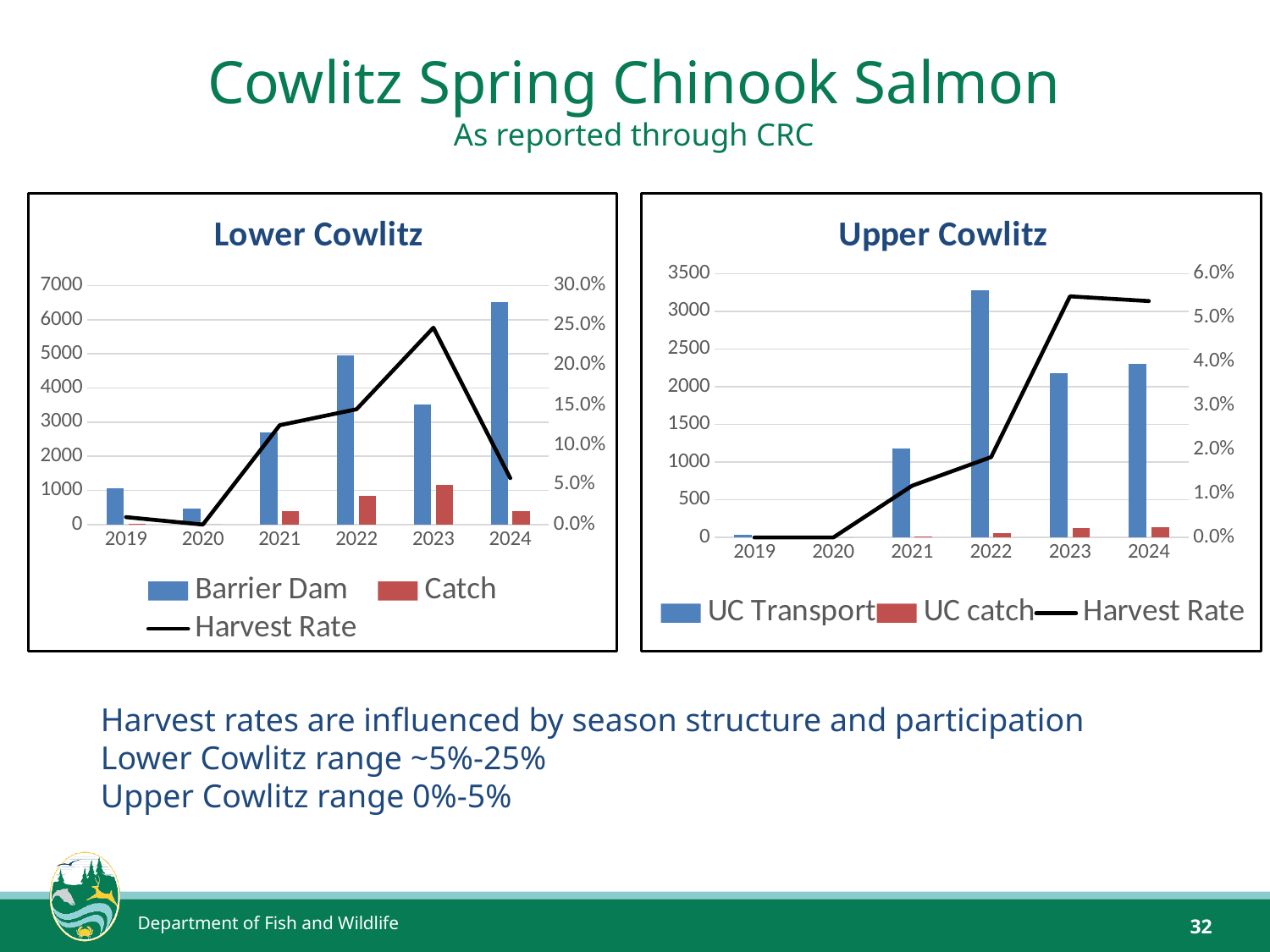
In the Upper Cowlitz chart, which year has the highest UC Transport value? 2022 In the Lower Cowlitz chart, which year has the highest Catch value? 2023 In the Upper Cowlitz chart, is the Harvest Rate for 2023 greater or less than 5.0%? greater In the Upper Cowlitz chart, does the Harvest Rate rise or fall from 2020 to 2023? rise In the Upper Cowlitz chart, is the UC Transport value for 2022 greater or less than 3000? greater How many series does the legend of the Lower Cowlitz chart list? 3 How many years are shown on the x axis of the Upper Cowlitz chart? 6 In the Lower Cowlitz chart, which year has the highest Harvest Rate? 2023 In the Lower Cowlitz chart, is the Barrier Dam value for 2020 greater or less than 1000? less In the Lower Cowlitz chart, which is larger, the Barrier Dam value for 2022 or for 2023? 2022